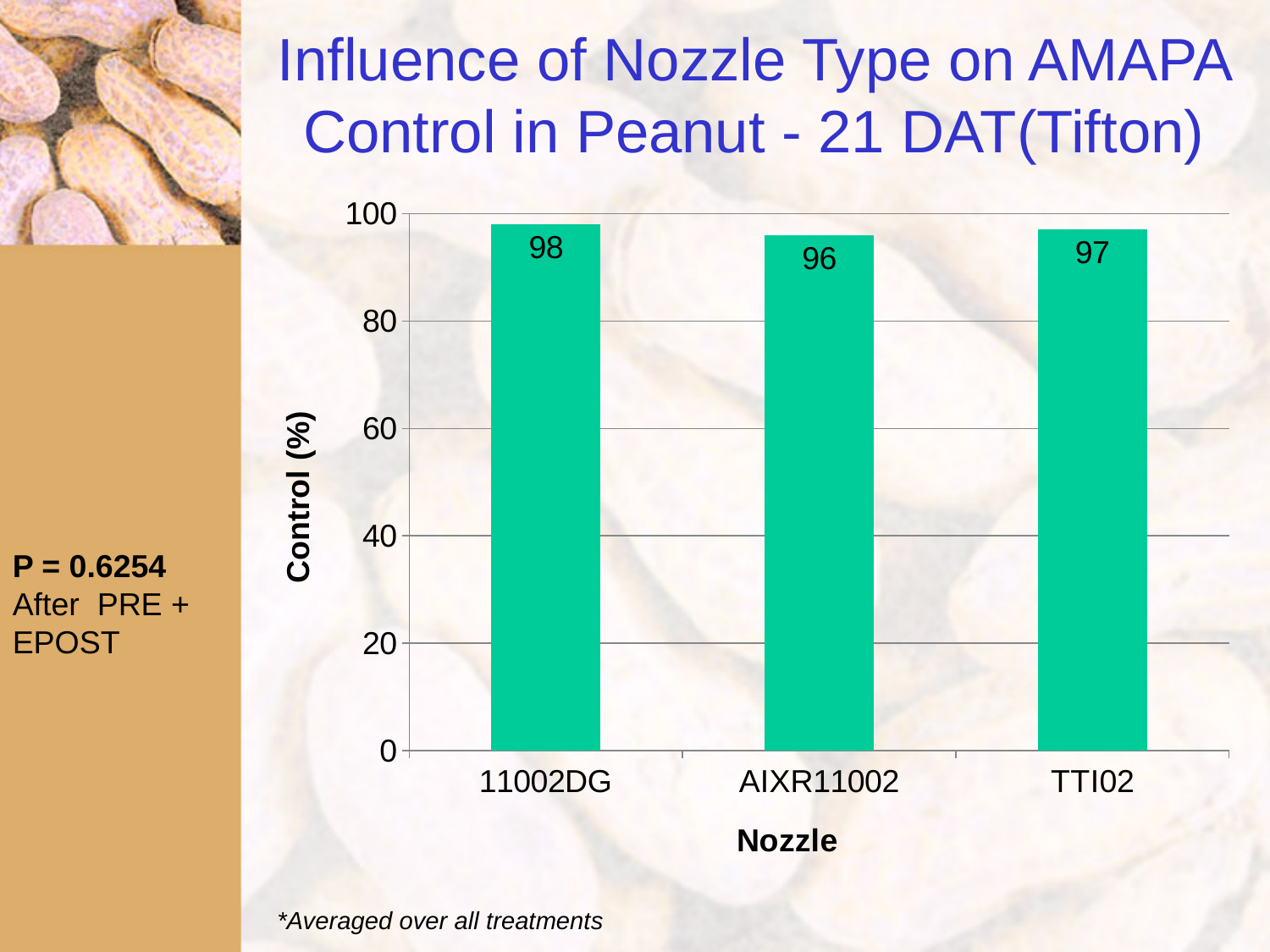
What is the difference in control (%) between TTI02 and AIXR11002? 1 What is the control (%) value for the 11002DG nozzle? 98 Which nozzle has the highest control (%)? 11002DG What is the difference in control (%) between 11002DG and AIXR11002? 2 What is the control (%) value for the TTI02 nozzle? 97 What kind of chart is shown on the slide? bar chart What is the label of the y axis? Control (%) What is the control (%) value for the AIXR11002 nozzle? 96 How many nozzle types are shown on the chart? 3 Is the value for AIXR11002 greater or less than 80? greater Which nozzle has the lowest control (%)? AIXR11002 Which has a higher control (%), 11002DG or TTI02? 11002DG